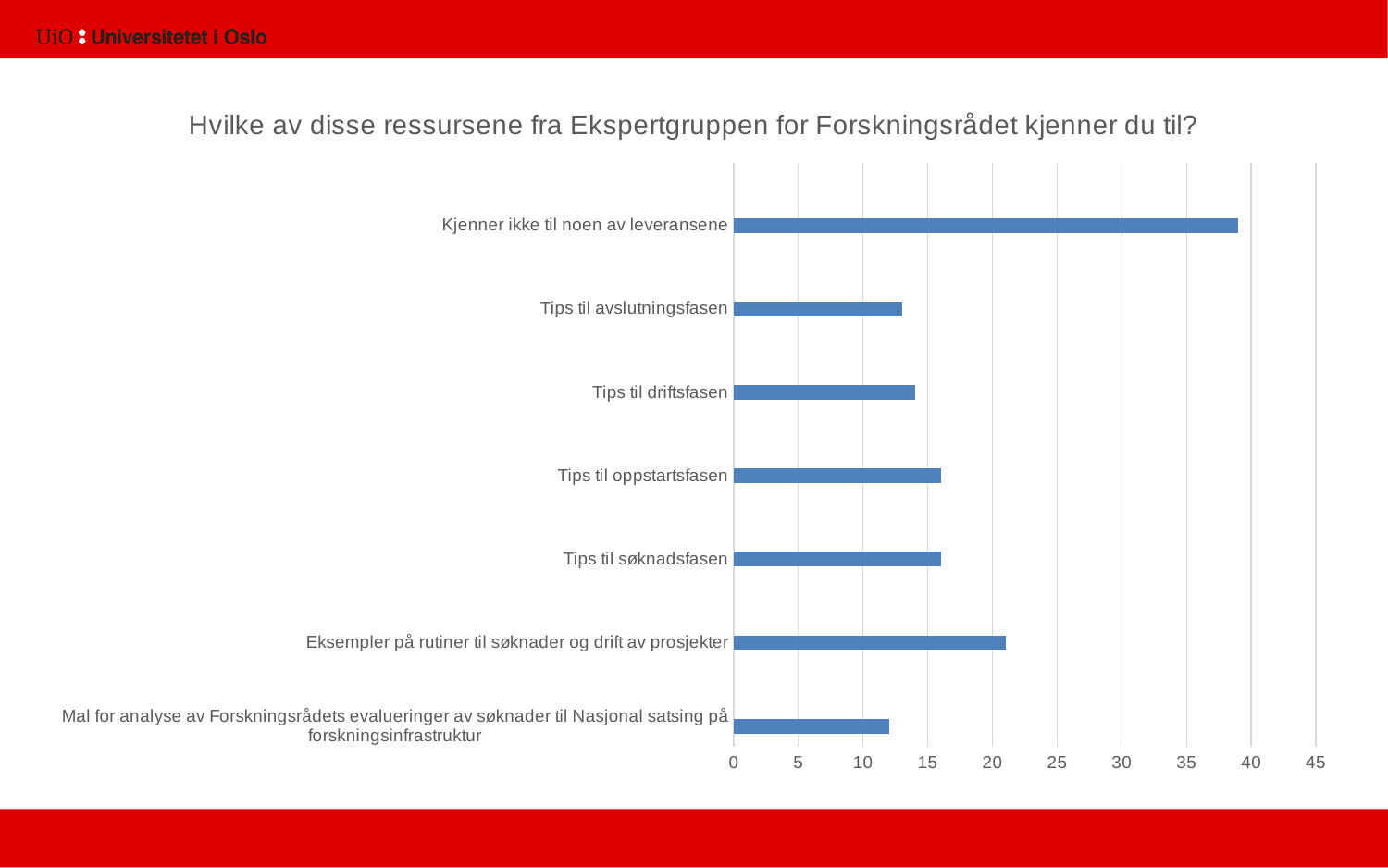
How many categories are plotted in the chart? 7 Which is larger: the value for Kjenner ikke til noen av leveransene or the value for Eksempler på rutiner til søknader og drift av prosjekter? Kjenner ikke til noen av leveransene Is the value for Mal for analyse av Forskningsrådets evalueringer av søknader til Nasjonal satsing på forskningsinfrastruktur greater or less than 15? less Is the value for Tips til driftsfasen greater or less than 20? less Is the value for Tips til søknadsfasen greater or less than 20? less Which category has the highest value? Kjenner ikke til noen av leveransene What kind of chart is shown on the slide? bar chart Which is larger: the value for Eksempler på rutiner til søknader og drift av prosjekter or the value for Tips til oppstartsfasen? Eksempler på rutiner til søknader og drift av prosjekter What is the title of the chart? Hvilke av disse ressursene fra Ekspertgruppen for Forskningsrådet kjenner du til?